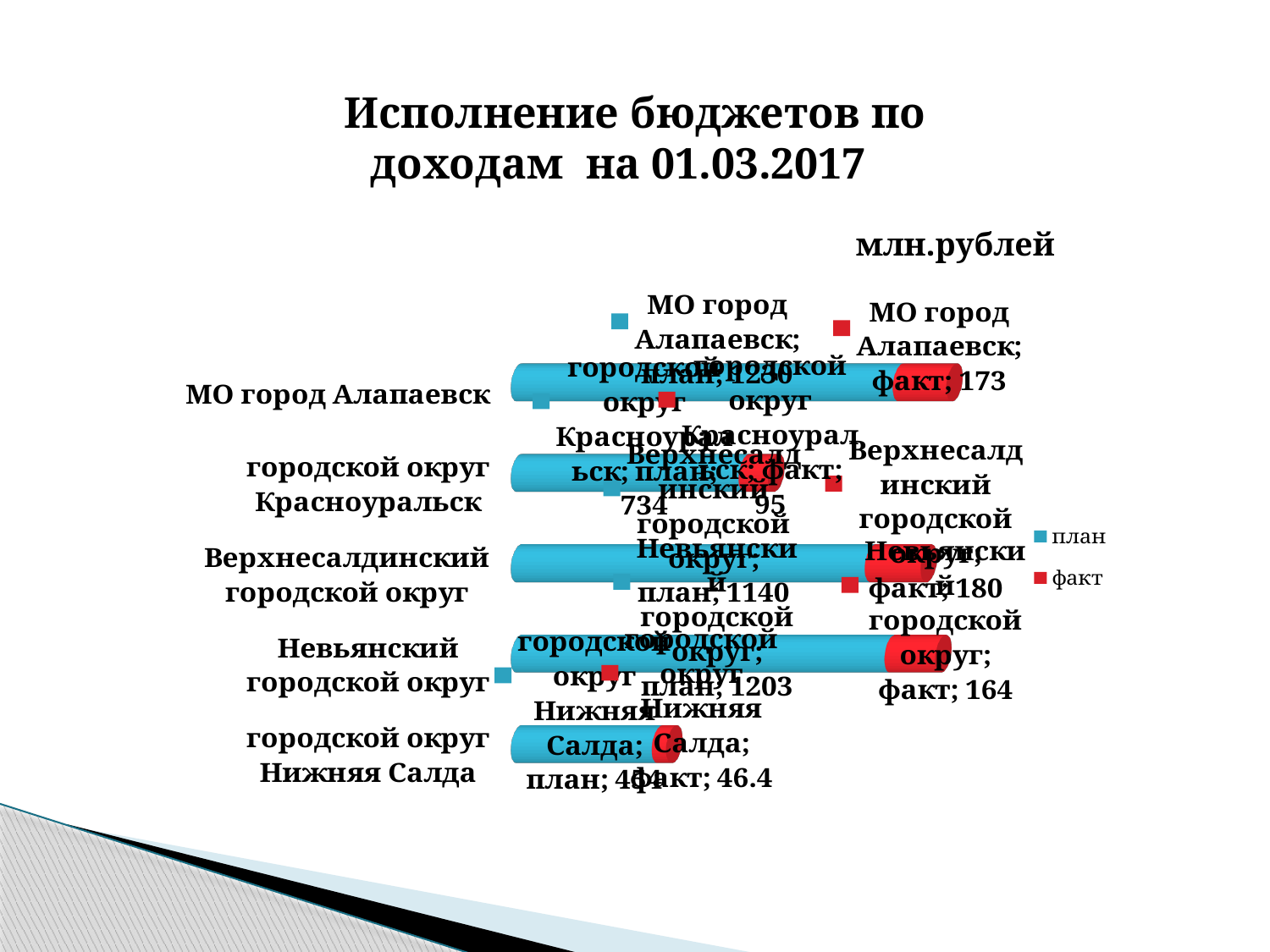
What is the difference between the план and факт values for Невьянский городской округ? 1039 What is the факт value for МО город Алапаевск? 173 What is the план value for Верхнесалдинский городской округ? 1140 In what units are the values in the chart given? млн.рублей How many series does the legend list? 2 Which municipality has the lowest факт value? городской округ Нижняя Салда What is the план value for городской округ Красноуральск? 734 How many municipalities (categories) are shown in the chart? 5 What is the факт value for городской округ Красноуральск? 95 What is the факт value for городской округ Нижняя Салда? 46.4 What is the факт value for Невьянский городской округ? 164 What kind of chart is shown on the slide? bar chart